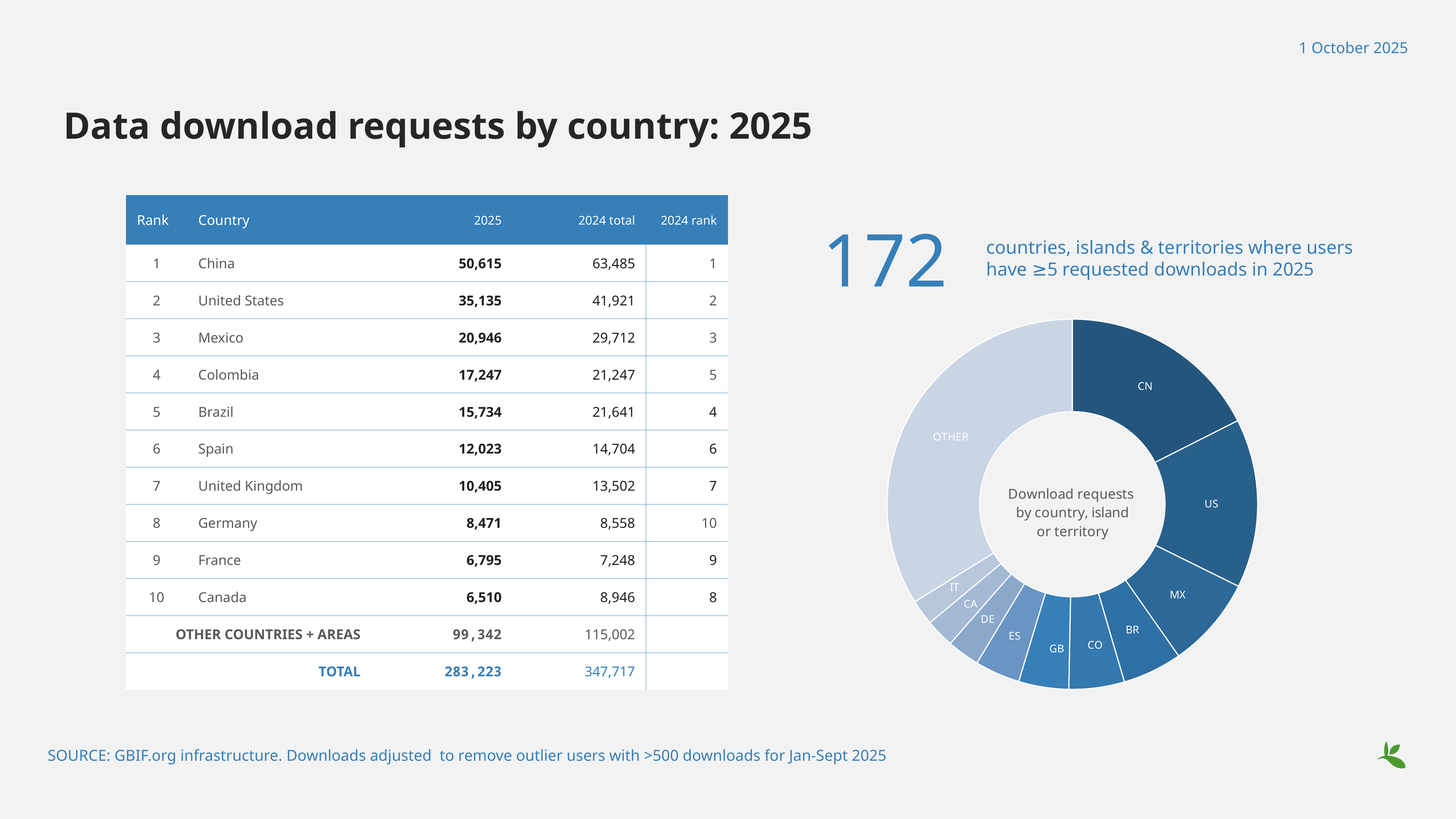
Which individual country slice of the donut chart is the largest? CN Which slice of the donut chart is the smallest? IT What kind of chart is shown on the right of the slide? Donut (pie) chart In the table, what is the total number of download requests for 2025? 283,223 In the table, how many download requests did China have in 2025? 50,615 In the donut chart, which slice is larger, CO or GB? CO What large number is shown above the donut chart? 172 In the donut chart, which slice is larger, CN or US? CN In the table, what is the difference between the 2025 values for China and the United States? 15,480 What text is written in the centre of the donut chart? Download requests by country, island or territory How many slices does the donut chart have? 11 Which slice of the donut chart is the largest? OTHER